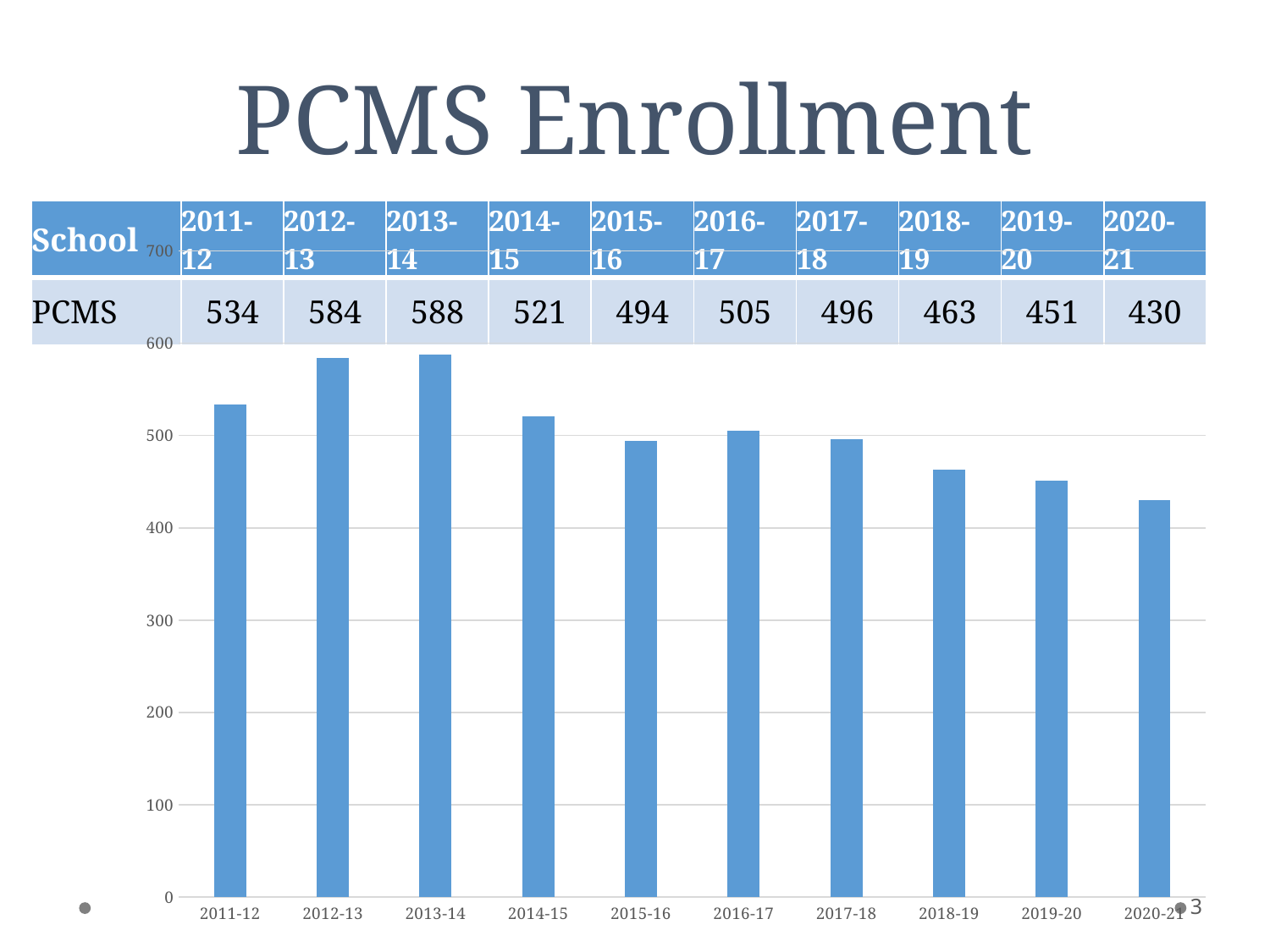
What is the difference in PCMS enrollment between 2013-14 and 2020-21? 158 How many school years are shown in the chart? 10 What was the PCMS enrollment in 2011-12? 534 What is the difference in PCMS enrollment between 2011-12 and 2012-13? 50 What is the overall trend in PCMS enrollment from 2013-14 to 2020-21? falling Which year had higher PCMS enrollment, 2014-15 or 2018-19? 2014-15 Which school year had the highest PCMS enrollment? 2013-14 Is the PCMS enrollment for 2015-16 greater or less than 500? less What was the PCMS enrollment in 2020-21? 430 What was the PCMS enrollment in 2016-17? 505 Which school year had the lowest PCMS enrollment? 2020-21 What kind of chart is used to show PCMS enrollment? bar chart